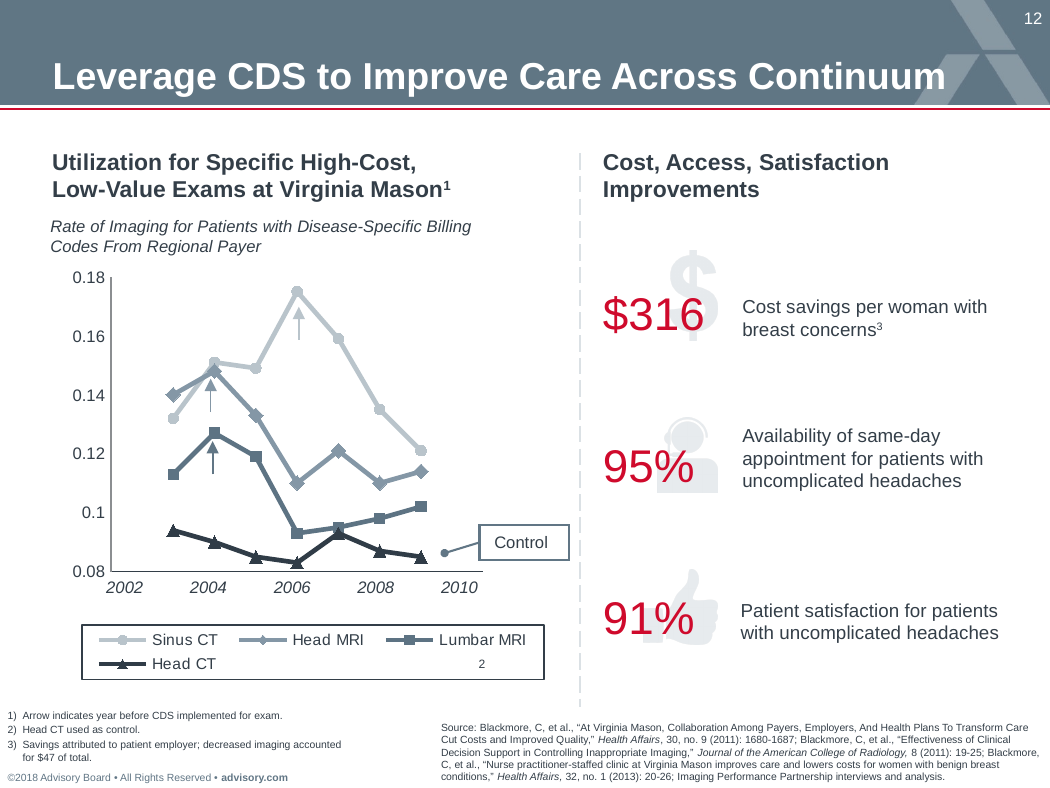
Which series has the lowest imaging rate in 2006? Head CT Is the Sinus CT value in 2006 greater or less than 0.16? greater Is the Lumbar MRI value in 2004 greater or less than 0.12? greater In 2008, which is larger: the Sinus CT rate or the Head CT rate? Sinus CT Is the Head CT value in 2006 greater or less than 0.1? less What kind of chart is used to show the rate of imaging at Virginia Mason? line chart Does the Sinus CT rate rise or fall from 2006 to 2009? fall What is the highest value shown on the y axis of the imaging rate chart? 0.18 Which series is labeled as the Control in the imaging rate chart? Head CT Which series has the highest imaging rate in 2006? Sinus CT How many series does the legend of the imaging rate chart list? 4